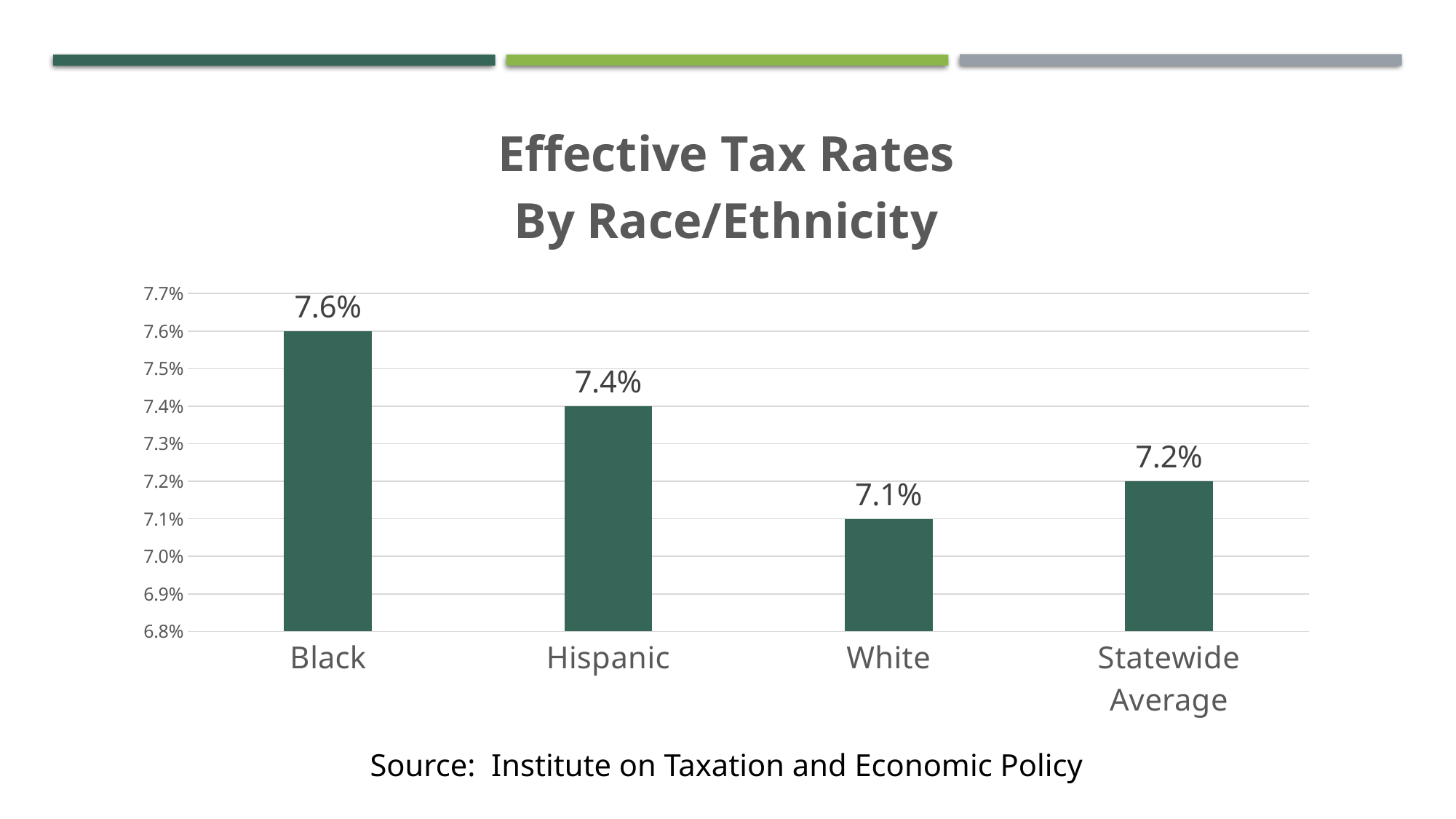
What is the title of the chart? Effective Tax Rates By Race/Ethnicity Which is larger, the effective tax rate for Hispanic taxpayers or the Statewide Average? Hispanic What is the effective tax rate for Hispanic taxpayers? 7.4% Which category has the highest effective tax rate? Black What is the effective tax rate for White taxpayers? 7.1% What kind of chart is shown on the slide? Bar chart What is the difference between the Hispanic effective tax rate and the Statewide Average? 0.2% What is the difference between the effective tax rate for Black taxpayers and for White taxpayers? 0.5% What is the Statewide Average effective tax rate? 7.2% What is the effective tax rate for Black taxpayers? 7.6% How many categories are shown on the chart? 4 Which category has the lowest effective tax rate? White